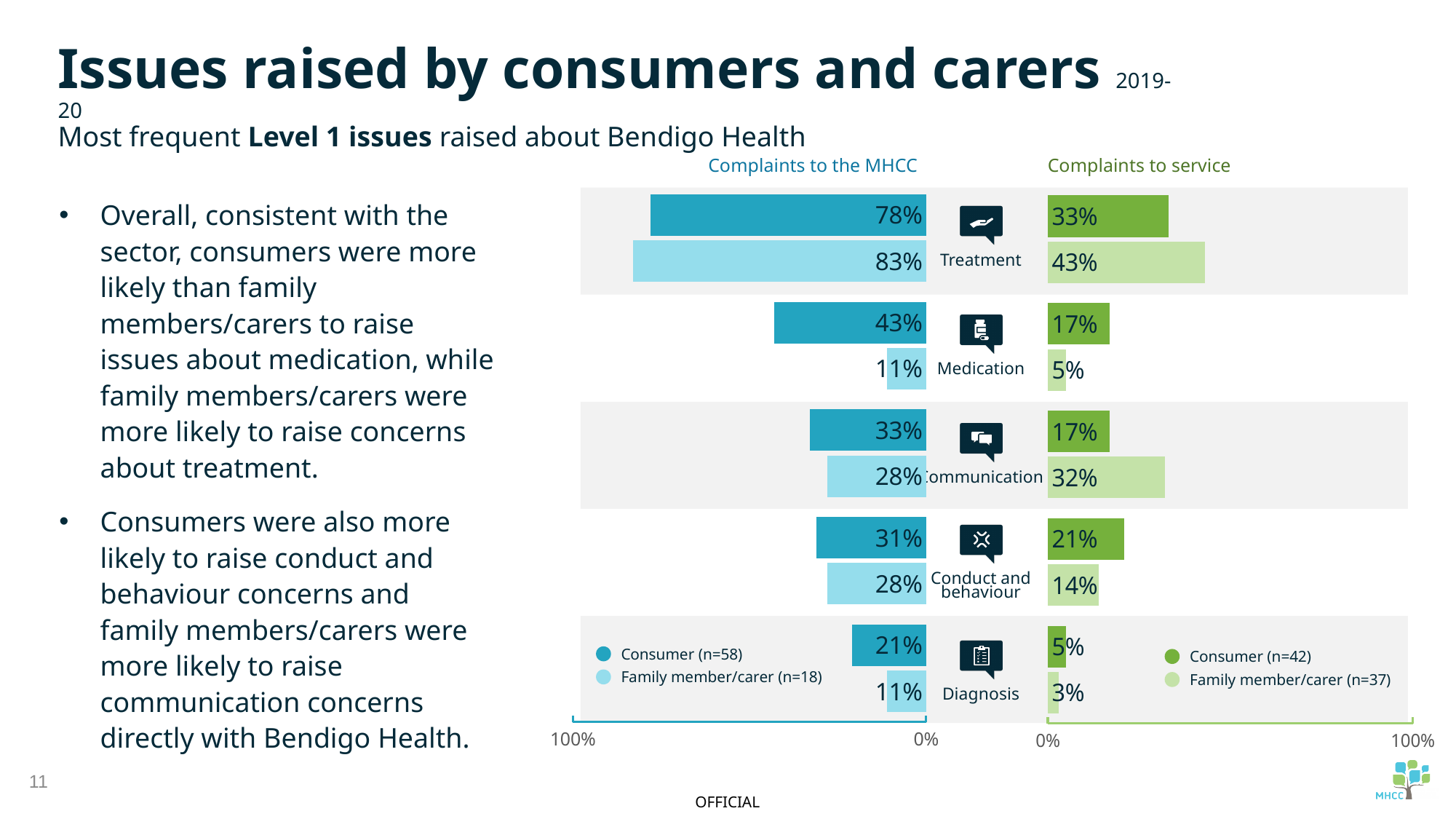
In the 'Complaints to the MHCC' chart, which issue has the highest value for consumers? Treatment In the 'Complaints to service' chart, what percentage of family members/carers raised issues about Communication? 32% In the 'Complaints to the MHCC' chart, what is the difference between the consumer and family member/carer values for Medication? 32% In the 'Complaints to the MHCC' chart, what percentage of consumers raised issues about Treatment? 78% What type of chart is the 'Complaints to the MHCC' chart? Bar chart In the 'Complaints to service' chart, which issue has the lowest value for family members/carers? Diagnosis How many series does the legend of the 'Complaints to service' chart list? 2 In the 'Complaints to service' chart, what percentage of consumers raised issues about Diagnosis? 5% In the 'Complaints to the MHCC' chart, what sample size (n) is given for family members/carers in the legend? n=18 How many issue categories are shown in the 'Complaints to the MHCC' chart? 5 In the 'Complaints to service' chart, which is larger for Treatment: the consumer value or the family member/carer value? Family member/carer In the 'Complaints to the MHCC' chart, what percentage of family members/carers raised issues about Medication? 11%